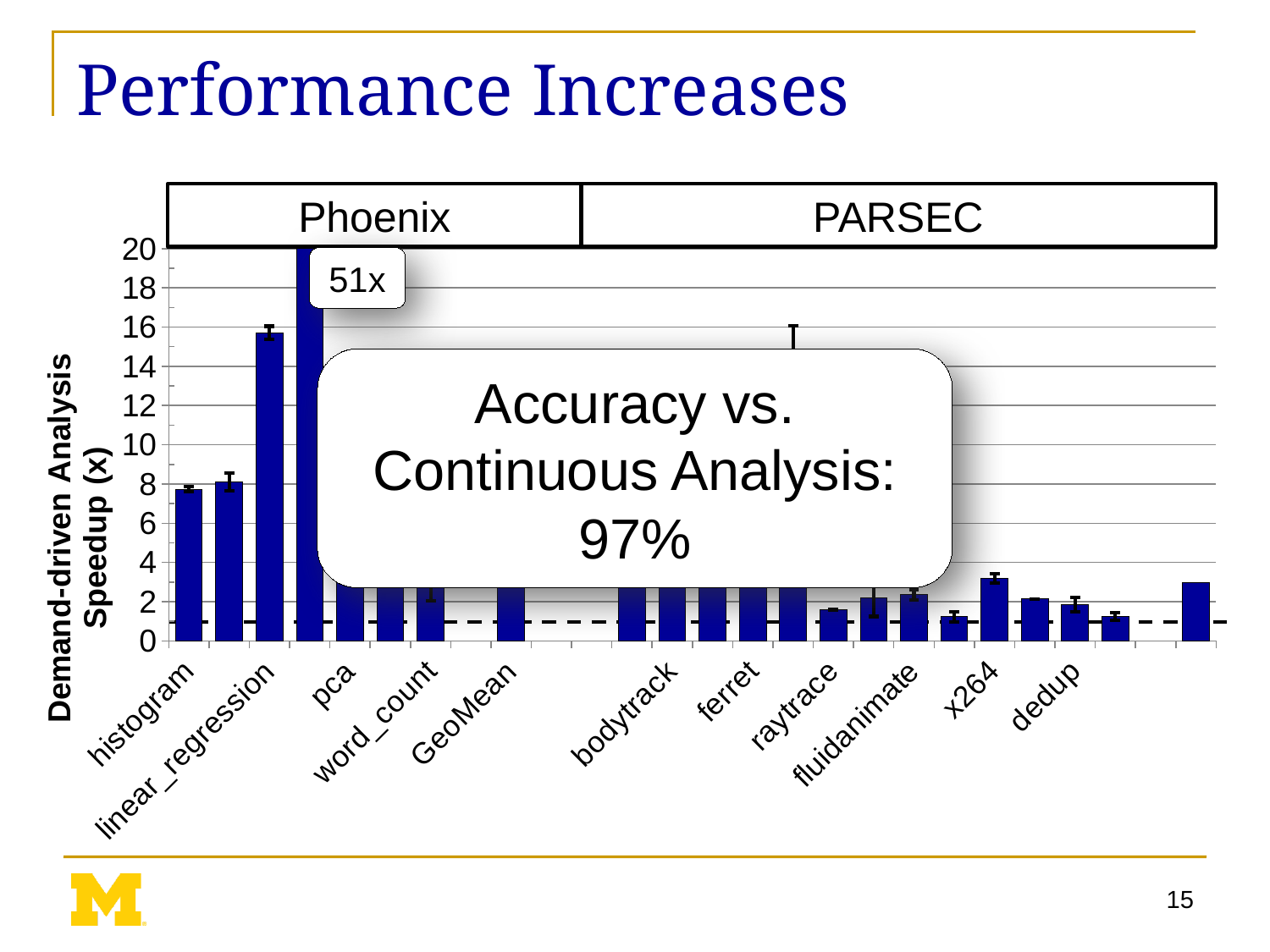
Is the speedup value for linear_regression greater or less than 6? greater What accuracy versus continuous analysis is stated in the overlay box on the chart? 97% Is the speedup value for linear_regression greater or less than 12? greater What speedup value is printed in the callout for the tallest bar in the chart? 51x What is the label of the y-axis of the chart? Demand-driven Analysis Speedup (x) What kind of chart is shown on the slide? bar chart What is the highest tick value shown on the y-axis? 20 Is the speedup value for histogram greater or less than 10? less What are the two benchmark suite groups labelled above the chart? Phoenix and PARSEC